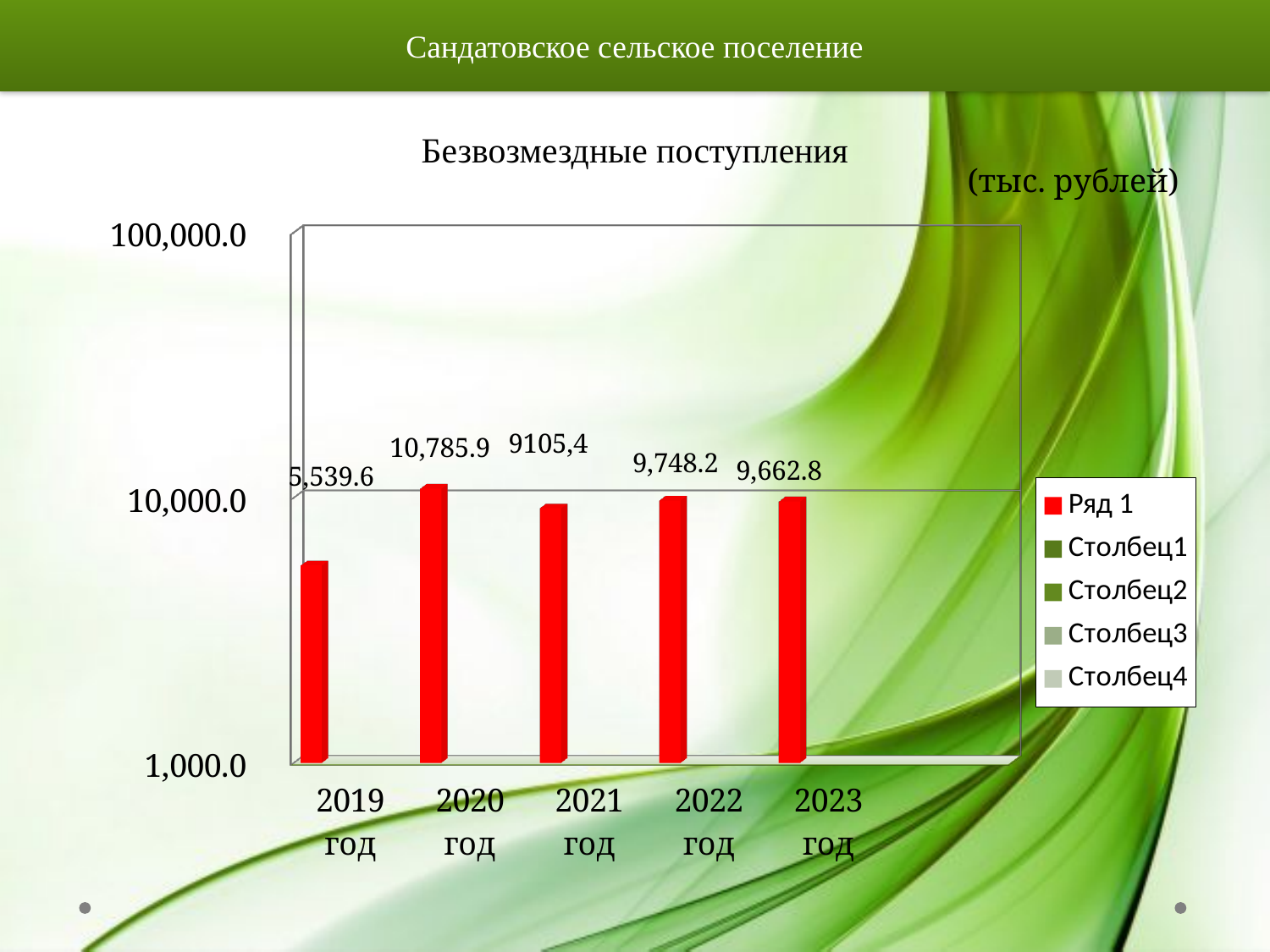
Which is larger, the value for 2022 год or 2023 год? 2022 год How many entries does the legend list? 5 How many years are shown on the x axis? 5 What is the value for 2019 год? 5,539.6 Which year has the highest value? 2020 год Is the value for 2019 год greater or less than 10,000.0? less What is the difference between the values for 2020 год and 2019 год? 5,246.3 Which year has the lowest value? 2019 год What is the value for 2020 год? 10,785.9 What is the value for 2021 год? 9105,4 What kind of chart is shown on the slide? bar chart What is the value for 2023 год? 9,662.8